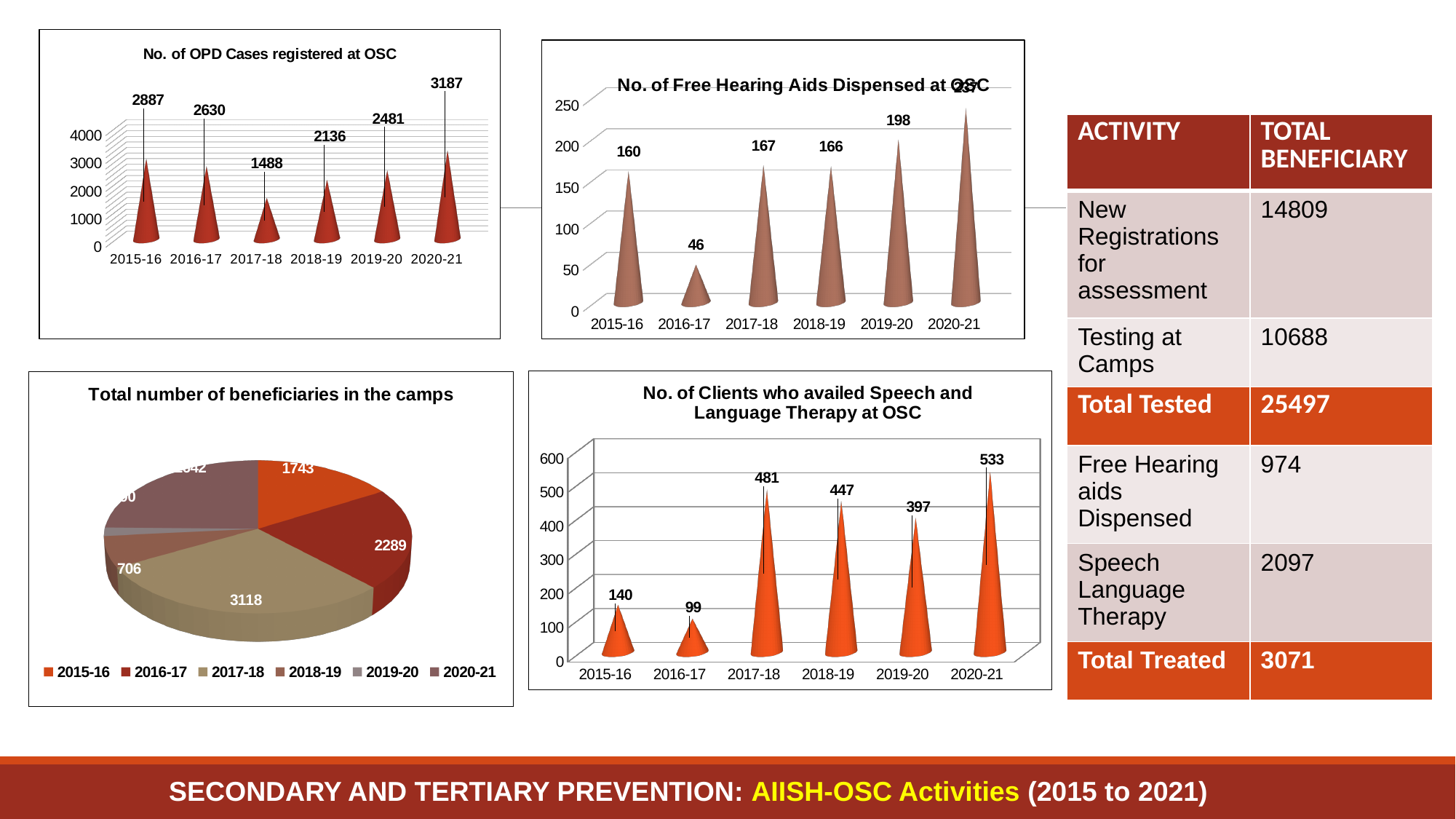
What kind of chart is 'Total number of beneficiaries in the camps'? Pie chart How many years are shown on the x axis of the chart 'No. of Clients who availed Speech and Language Therapy at OSC'? 6 In the chart 'No. of Free Hearing Aids Dispensed at OSC', which is larger, the value for 2017-18 or 2019-20? 2019-20 In the chart 'Total number of beneficiaries in the camps', what is the value for 2017-18? 3118 In the chart 'No. of OPD Cases registered at OSC', what is the value for 2020-21? 3187 In the chart 'No. of Clients who availed Speech and Language Therapy at OSC', what is the difference between the values for 2020-21 and 2017-18? 52 In the chart 'No. of Free Hearing Aids Dispensed at OSC', which year has the highest value? 2020-21 In the chart 'No. of OPD Cases registered at OSC', which year has the lowest value? 2017-18 How many entries does the legend of the chart 'Total number of beneficiaries in the camps' list? 6 In the chart 'No. of Clients who availed Speech and Language Therapy at OSC', what is the value for 2018-19? 447 In the chart 'No. of OPD Cases registered at OSC', what is the difference between the values for 2015-16 and 2016-17? 257 In the chart 'No. of Free Hearing Aids Dispensed at OSC', what is the value for 2016-17? 46